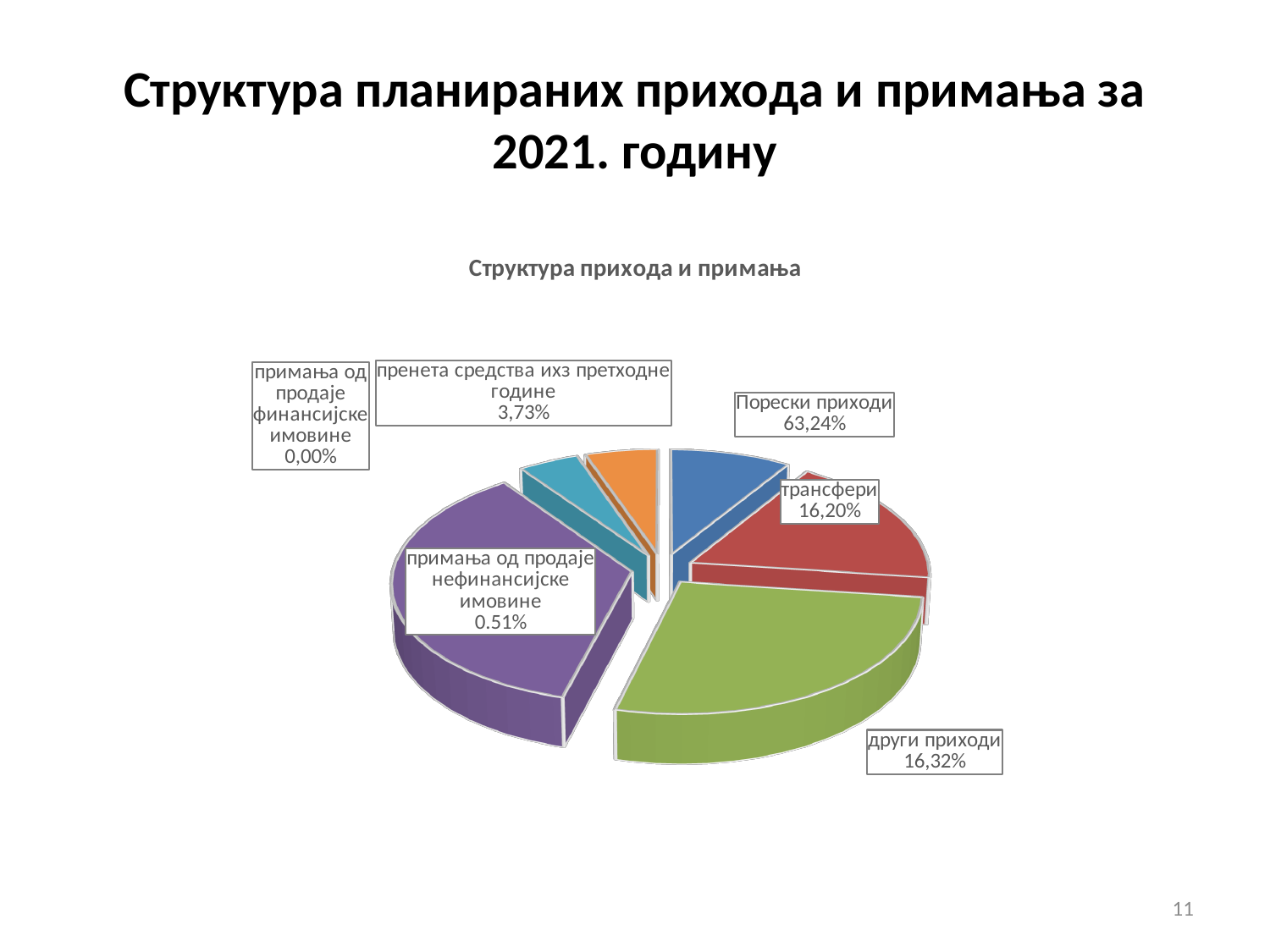
Which category has the highest percentage according to the data labels? Порески приходи Which category has the lowest percentage according to the data labels? примања од продаје финансијске имовине What percentage is shown for примања од продаје финансијске имовине? 0,00% What percentage is shown for трансфери? 16,20% What kind of chart is shown on the slide? pie chart What percentage is shown for други приходи? 16,32% What percentage is shown for пренета средства ихз претходне године? 3,73% Which has the larger labelled percentage, други приходи or трансфери? други приходи What is the title of the chart? Структура прихода и примања How many categories are labelled on the pie chart? 6 What percentage is shown for Порески приходи? 63,24% What is the difference between the percentages for Порески приходи and трансфери? 47,04%